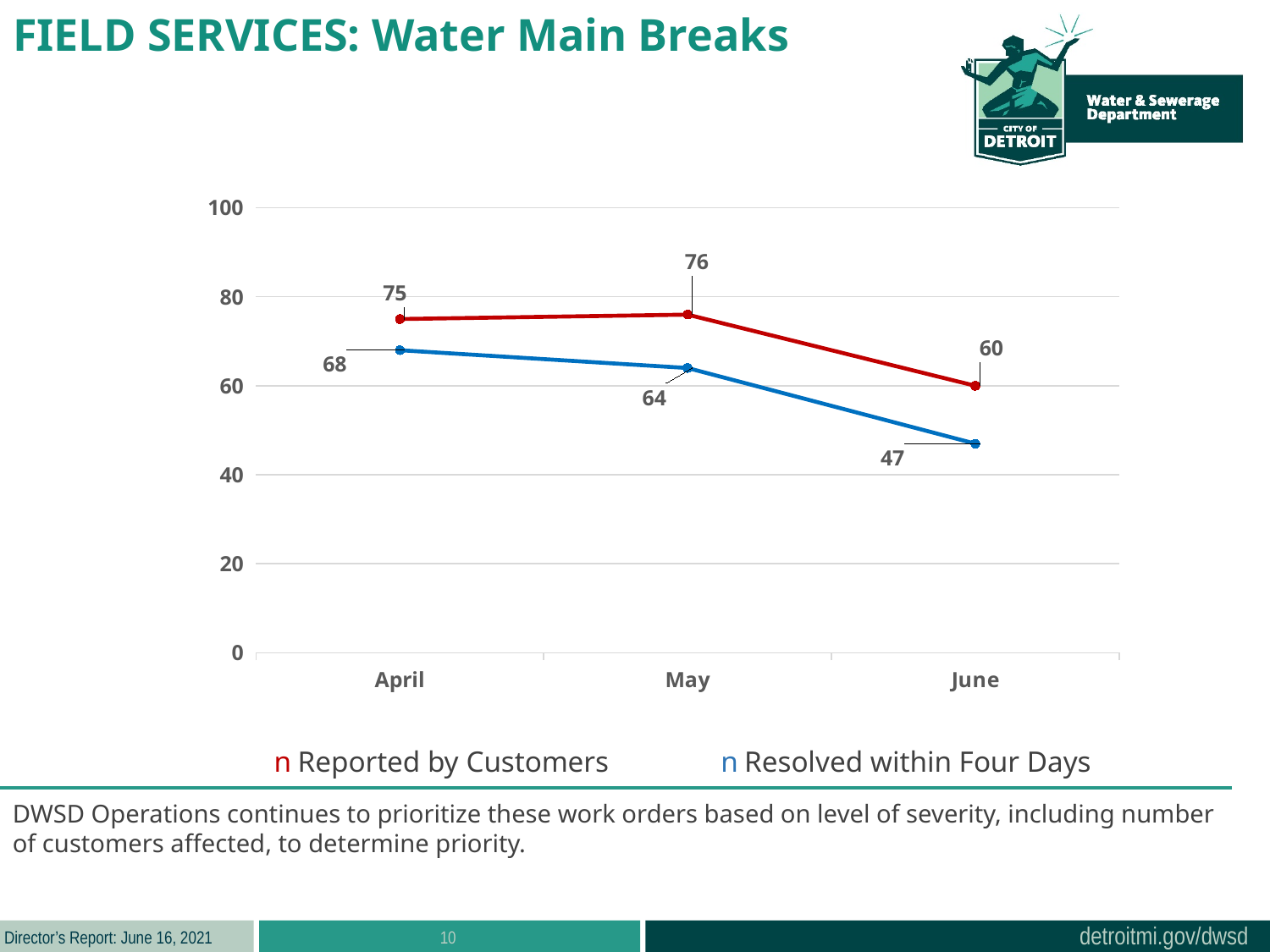
How many series does the legend list? 2 Which is larger in May: Reported by Customers or Resolved within Four Days? Reported by Customers Does Resolved within Four Days rise or fall from April to June? fall Is the value for Resolved within Four Days in June greater or less than 60? less What is the difference between Reported by Customers and Resolved within Four Days in June? 13 What is the value for Resolved within Four Days in June? 47 How many months are shown on the x axis? 3 In which month is Resolved within Four Days highest? April In which month is Reported by Customers lowest? June What is the value for Reported by Customers in May? 76 What kind of chart is shown on the slide? line chart What is the value for Reported by Customers in April? 75